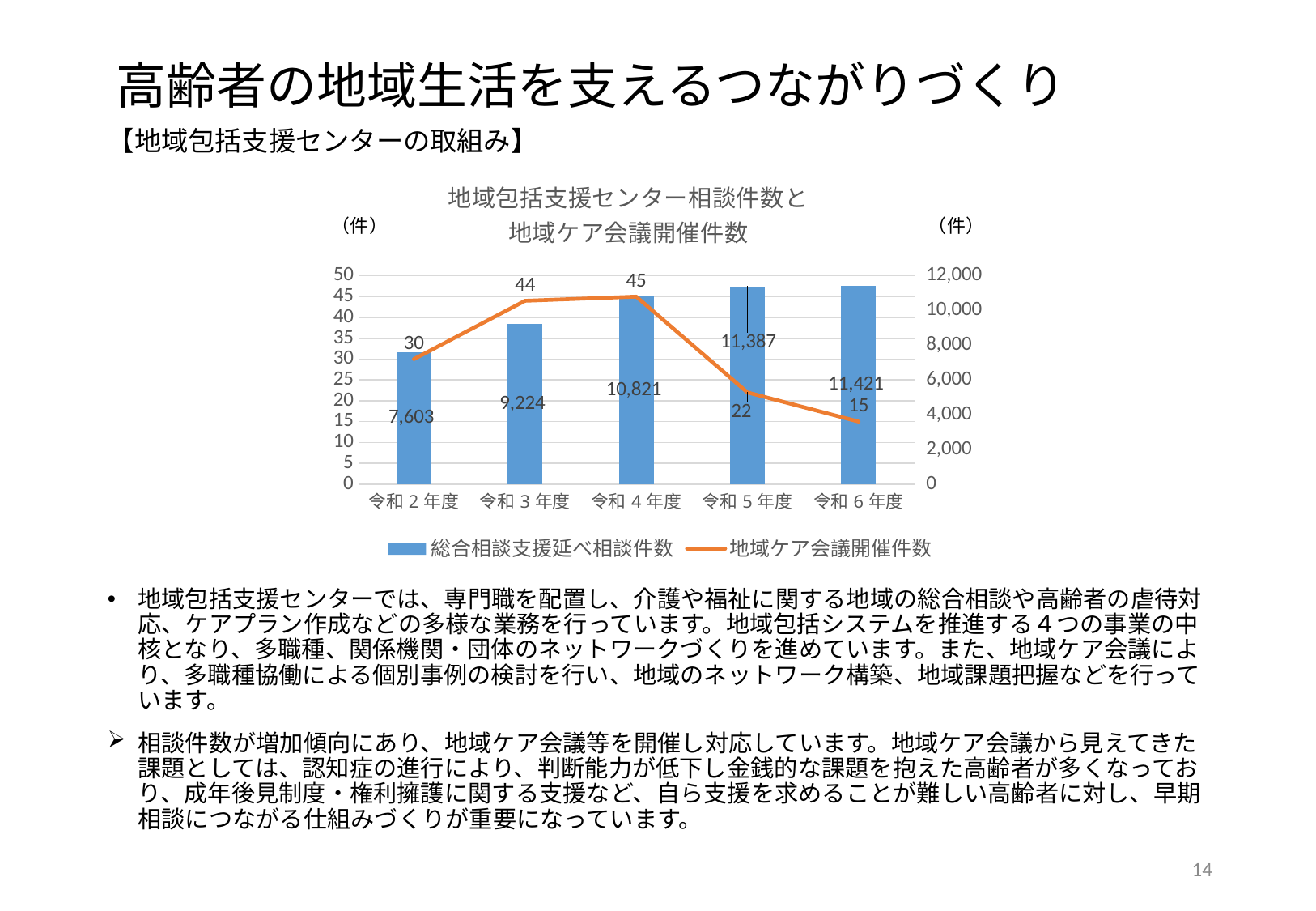
What is the difference in 総合相談支援延べ相談件数 between 令和３年度 and 令和２年度? 1,621 What kind of chart is this? Combined bar and line chart What is the value of 総合相談支援延べ相談件数 for 令和２年度? 7,603 What is the value of 総合相談支援延べ相談件数 for 令和６年度? 11,421 Is the 総合相談支援延べ相談件数 for 令和４年度 greater or less than 10,000? greater Which is larger, the 地域ケア会議開催件数 for 令和３年度 or for 令和５年度? 令和３年度 Does the 総合相談支援延べ相談件数 rise or fall from 令和２年度 to 令和６年度? rise Which fiscal year has the highest 総合相談支援延べ相談件数? 令和６年度 What is the value of 地域ケア会議開催件数 for 令和４年度? 45 Which fiscal year has the lowest 地域ケア会議開催件数? 令和６年度 How many fiscal years are shown on the x axis? 5 How many series does the legend list? 2